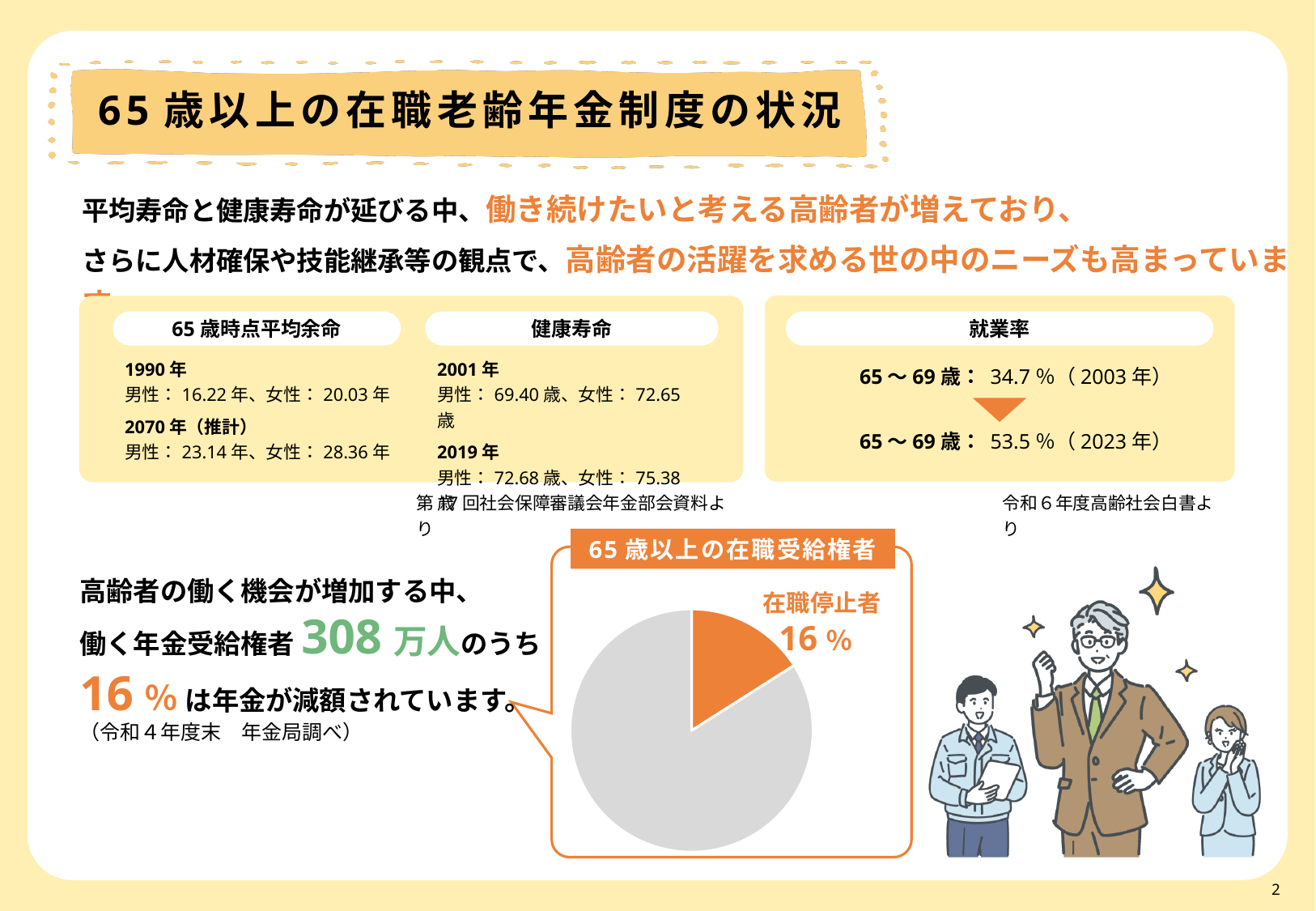
How many slices does the pie chart have? 2 What colour is the 在職停止者 slice in the pie chart? orange In the pie chart, which slice is larger: the orange 在職停止者 slice or the grey slice? the grey slice What is the title of the pie chart? 65歳以上の在職受給権者 In the pie chart, what share is labelled for 在職停止者? 16% What value is printed next to the 在職停止者 slice of the pie chart? 16% What kind of chart is shown on the slide? pie chart Which slice of the pie chart is the smallest? 在職停止者